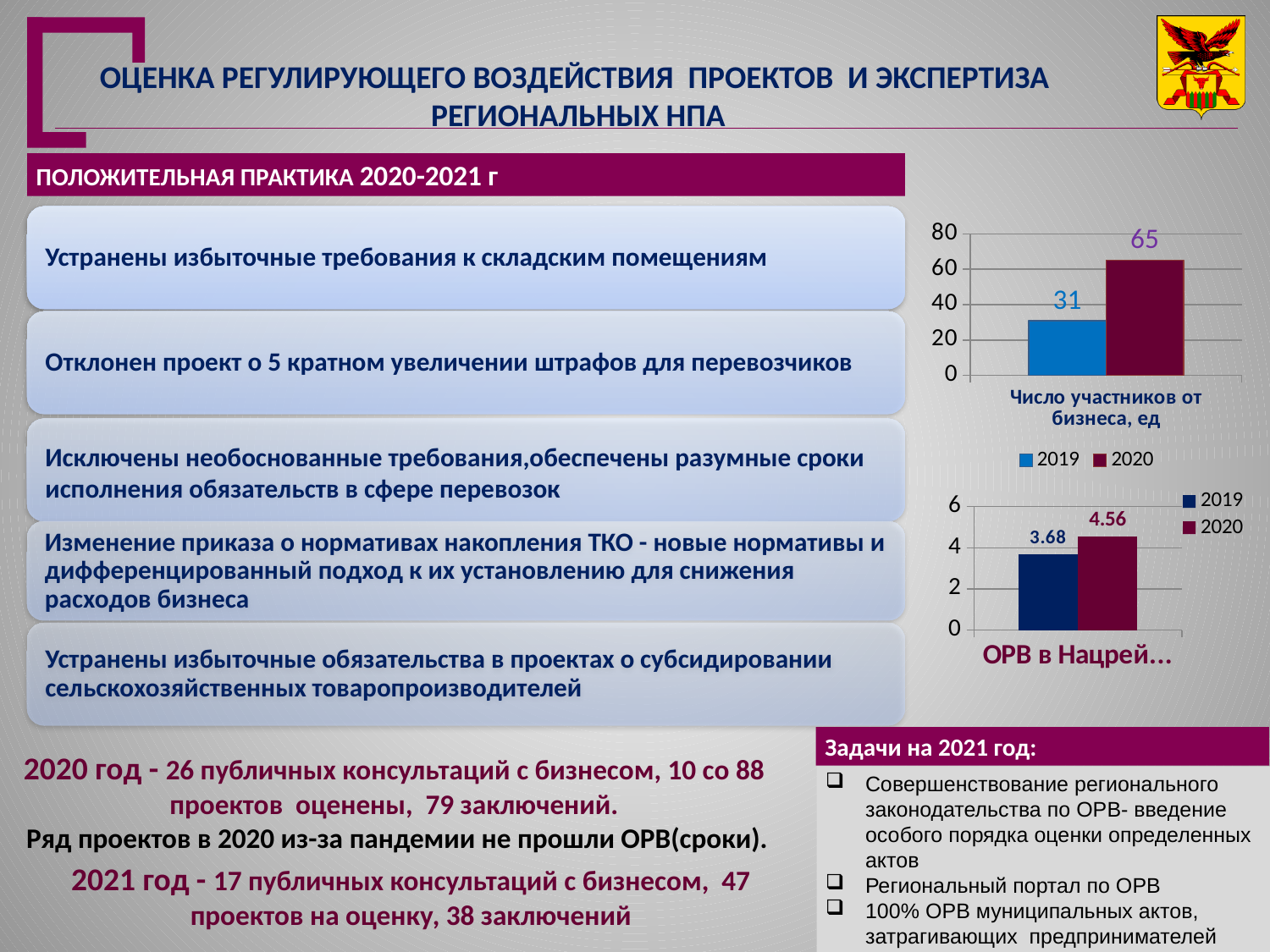
In the bottom chart (ОРВ в Нацрей...), what colour is the bar for 2020? dark red In the top chart (Число участников от бизнеса, ед), is the value for 2020 greater or less than 60? greater In the top chart (Число участников от бизнеса, ед), what is the value for 2020? 65 In the top chart (Число участников от бизнеса, ед), what is the value for 2019? 31 In the top chart (Число участников от бизнеса, ед), which year has the higher value? 2020 In the top chart (Число участников от бизнеса, ед), how many series does the legend list? 2 In the bottom chart (ОРВ в Нацрей...), what is the value for 2019? 3.68 In the bottom chart (ОРВ в Нацрей...), is the value for 2019 greater or less than 4? less In the bottom chart (ОРВ в Нацрей...), what is the value for 2020? 4.56 In the top chart (Число участников от бизнеса, ед), what is the difference between the 2020 and 2019 values? 34 In the bottom chart (ОРВ в Нацрей...), which year has the lower value? 2019 What type of chart is the top chart on the right side of the slide? bar chart